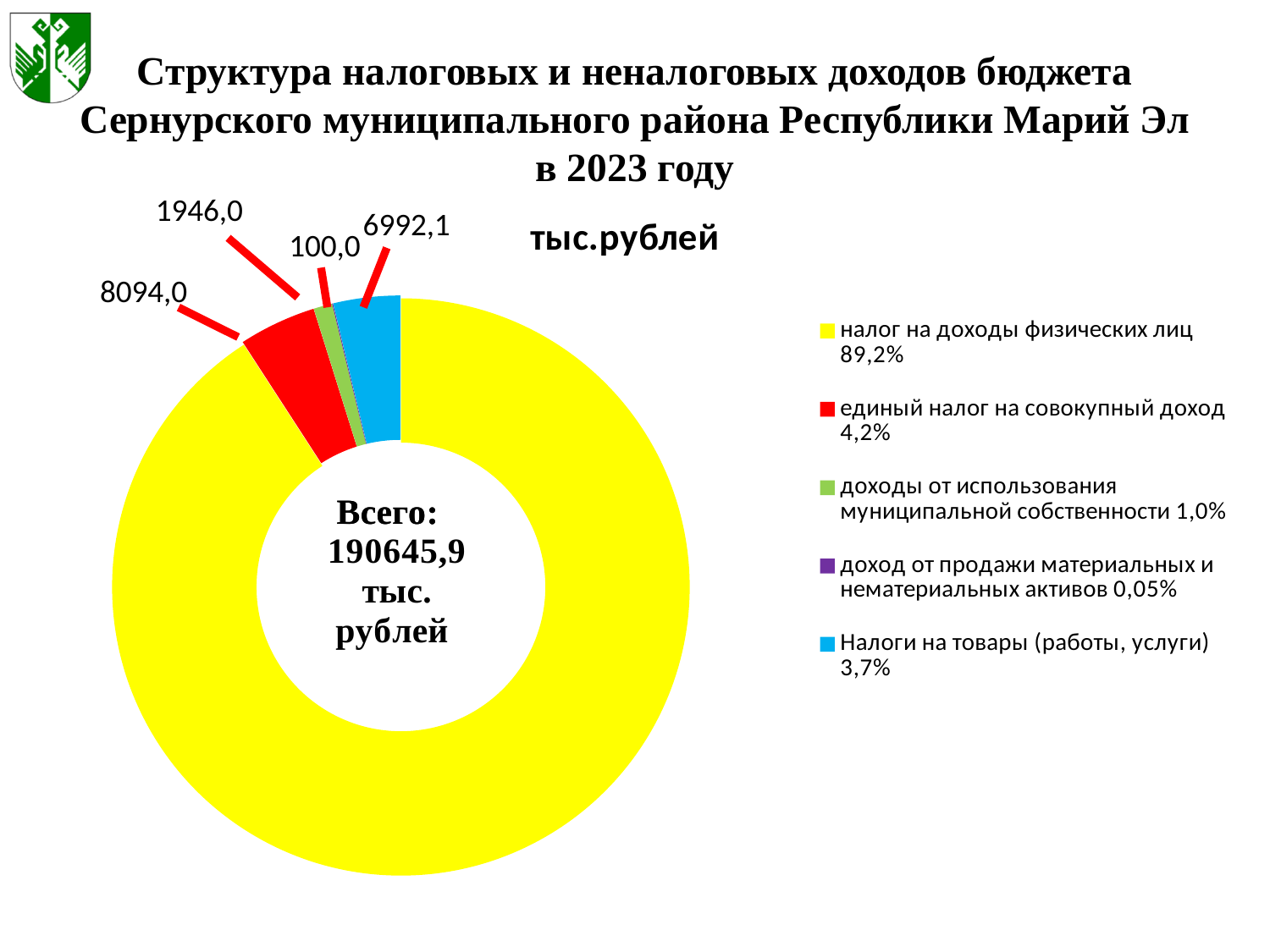
What total is shown in the centre of the chart? 190645,9 тыс. рублей What is the value for единый налог на совокупный доход? 8094,0 What is the difference between the values for единый налог на совокупный доход and Налоги на товары (работы, услуги)? 1101,9 Which category has the smallest slice? доход от продажи материальных и нематериальных активов What is the value for доходы от использования муниципальной собственности? 1946,0 What share of the total does единый налог на совокупный доход make up? 4,2% How many categories does the legend list? 5 Which category has the largest slice? налог на доходы физических лиц What share of the total does налог на доходы физических лиц make up? 89,2% What is the value for доход от продажи материальных и нематериальных активов? 100,0 What is the value for Налоги на товары (работы, услуги)? 6992,1 What kind of chart is shown on the slide? pie chart (doughnut)